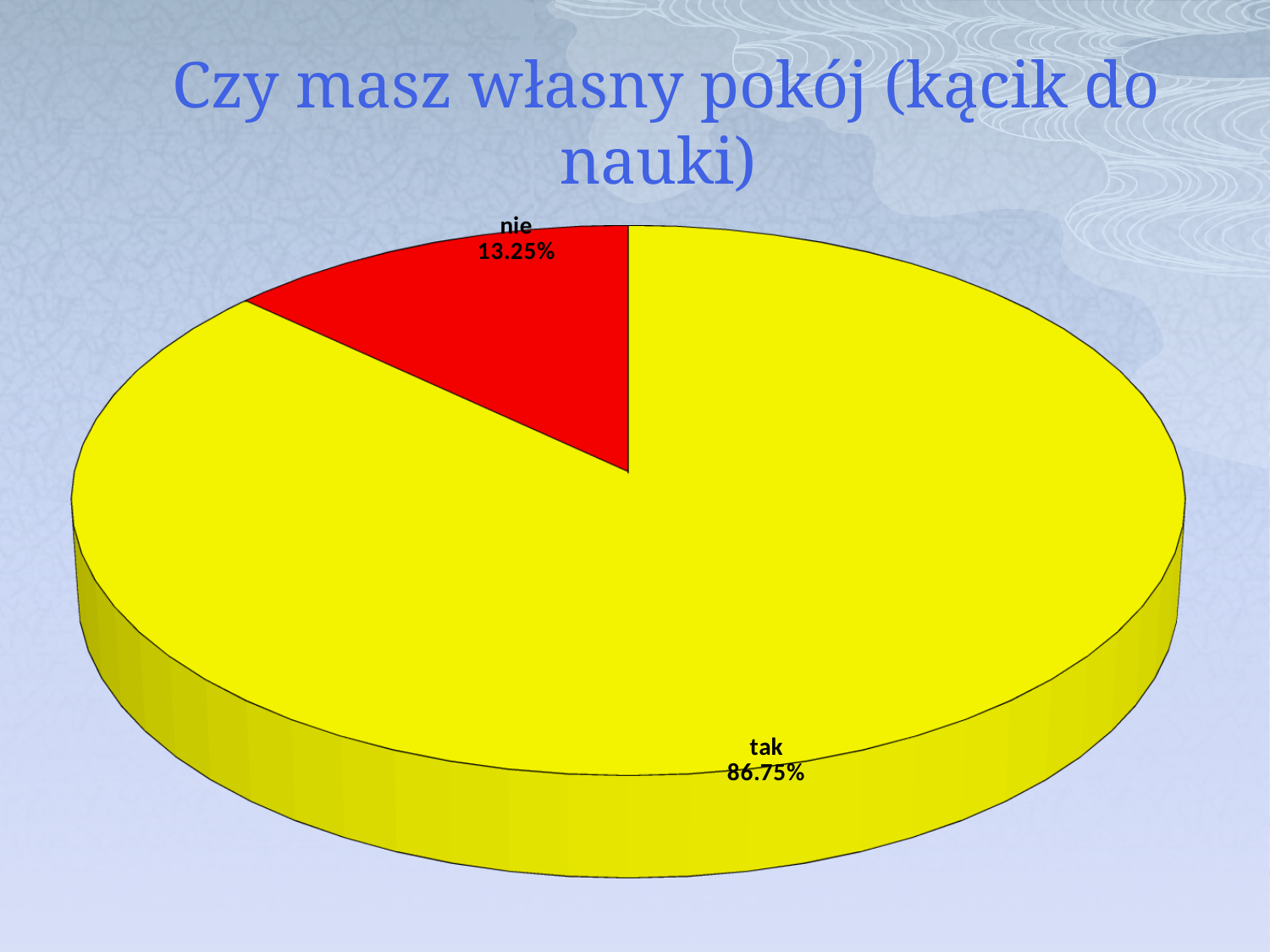
What percentage of respondents answered "tak"? 86.75% How many slices does the pie chart have? 2 What kind of chart is shown on the slide? pie chart What colour is the "nie" slice? red Which slice is the largest? tak What share of the pie does the "nie" slice represent? 13.25% What is the title of the chart on the slide? Czy masz własny pokój (kącik do nauki) What is the difference in percentage points between the "tak" and "nie" slices? 73.5 Which is larger, the "tak" slice or the "nie" slice? tak Which slice is the smallest? nie What percentage of respondents answered "nie"? 13.25%